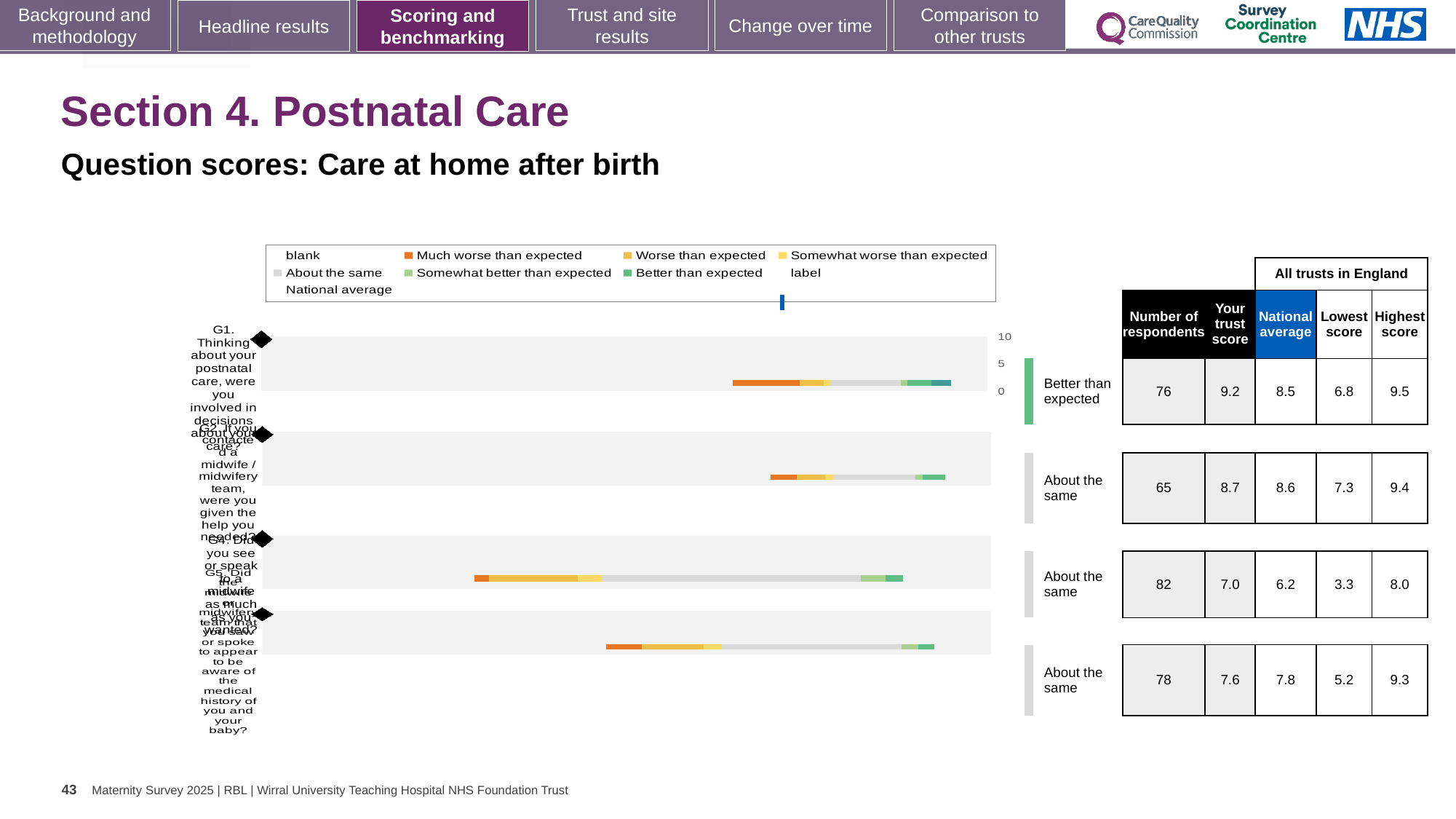
How many question bars are plotted in the chart? 4 By how much does the trust score for the first row (G1) exceed its national average? 0.7 What is the highest score across all trusts in England for the fourth (bottom) question row? 9.3 What kind of chart is shown on the slide? bar chart Which question row has the highest trust score? the first (top) row, G1 For the third question row, which is larger: the trust score or the national average? the trust score (7.0) How many question rows are rated 'About the same'? 3 What is the trust score for the first (top) question, G1? 9.2 In the table, what is the number of respondents for the first (top) question, G1? 76 Which question row has the lowest trust score? the third row What is the national average for the second question row? 8.6 What benchmark rating is given to the first (top) question row? Better than expected